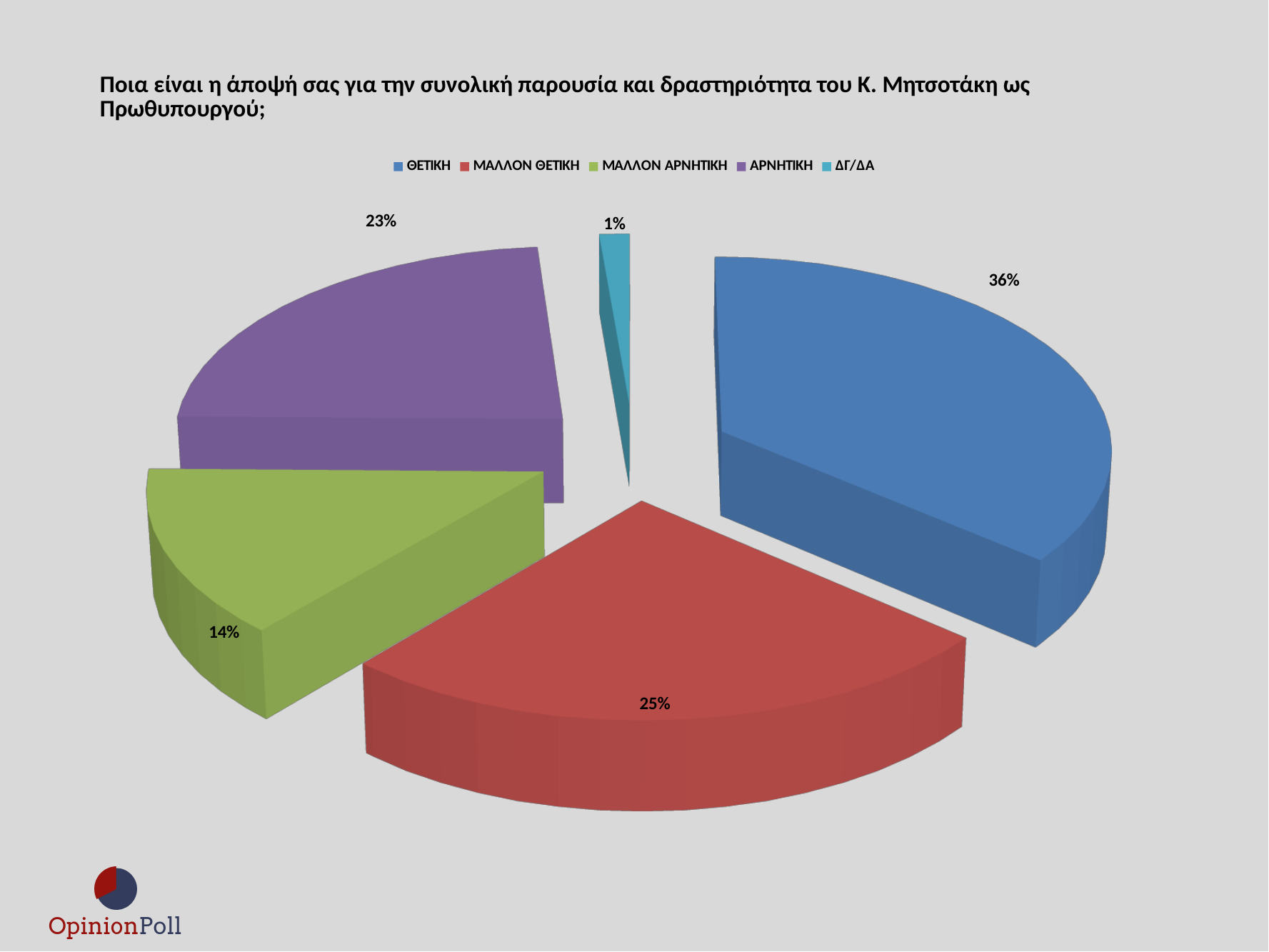
What is the difference between the ΘΕΤΙΚΗ and ΑΡΝΗΤΙΚΗ shares? 13% What share of the pie does ΑΡΝΗΤΙΚΗ have? 23% What share of the pie does ΔΓ/ΔΑ have? 1% What share of the pie does ΜΑΛΛΟΝ ΘΕΤΙΚΗ have? 25% What colour is the ΑΡΝΗΤΙΚΗ slice? Purple Which category has the smallest slice of the pie? ΔΓ/ΔΑ What share of the pie does ΘΕΤΙΚΗ have? 36% What share of the pie does ΜΑΛΛΟΝ ΑΡΝΗΤΙΚΗ have? 14% Which category has the largest slice of the pie? ΘΕΤΙΚΗ How many categories does the legend list? 5 What kind of chart is shown on the slide? Pie chart Which is larger, the ΜΑΛΛΟΝ ΘΕΤΙΚΗ slice or the ΑΡΝΗΤΙΚΗ slice? ΜΑΛΛΟΝ ΘΕΤΙΚΗ